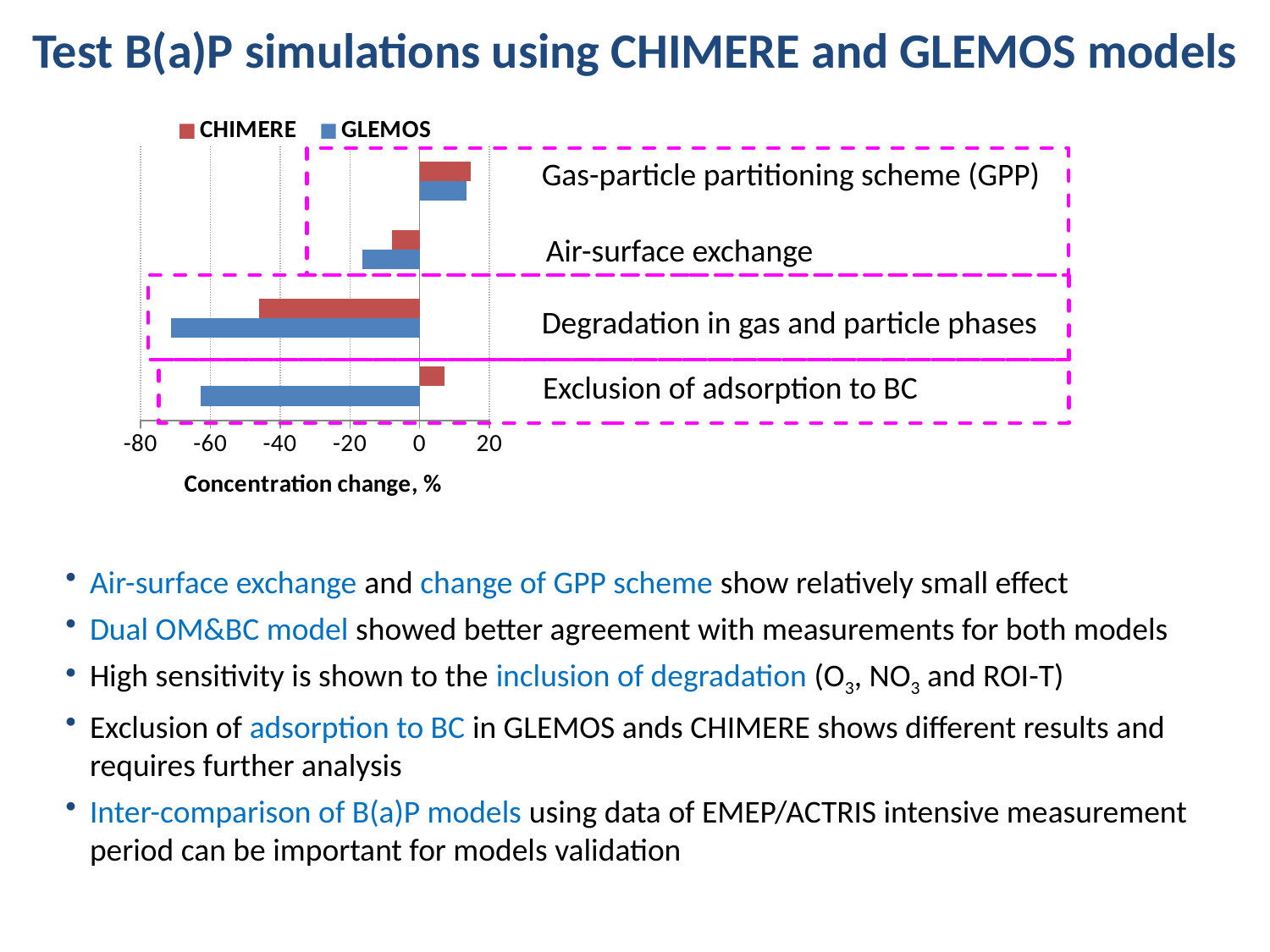
Is the CHIMERE value for Degradation in gas and particle phases greater or less than -40? less Which two series are listed in the chart legend? CHIMERE and GLEMOS Is the GLEMOS value for Exclusion of adsorption to BC greater or less than -40? less Is the CHIMERE value for Exclusion of adsorption to BC greater or less than 0? greater How many categories (model test cases) are shown in the chart? 4 What kind of chart is shown on the slide? bar chart Which category has the lowest (most negative) GLEMOS value? Degradation in gas and particle phases How many series does the chart legend list? 2 For Degradation in gas and particle phases, which series shows the larger concentration decrease, CHIMERE or GLEMOS? GLEMOS What is the label of the horizontal axis of the chart? Concentration change, %